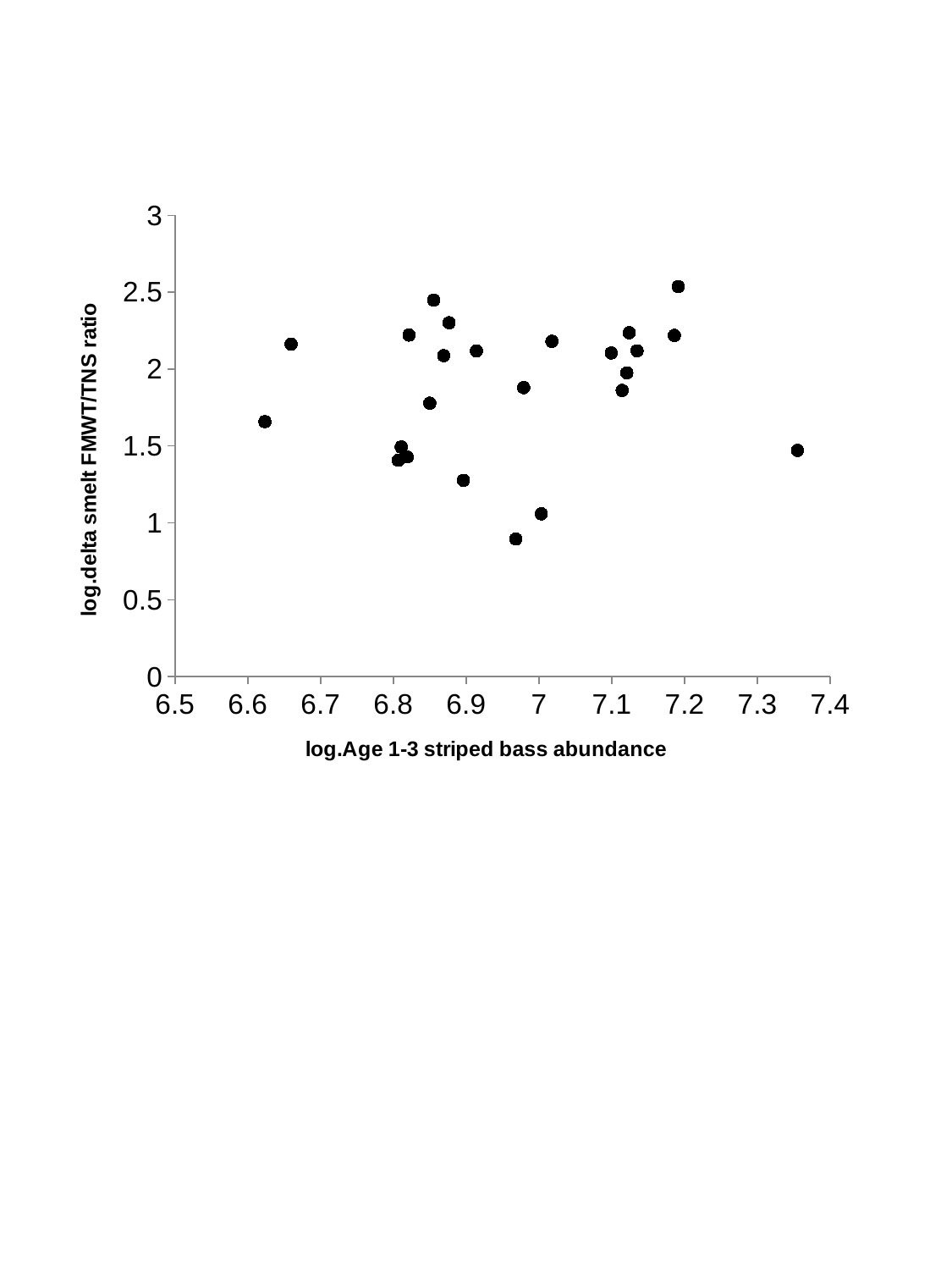
Is the y value of the highest point greater or less than 2? greater Is the x value of the rightmost point greater or less than 7.3? greater Is the x value of the leftmost point greater or less than 6.7? less What is the title of the x axis? log.Age 1-3 striped bass abundance Which has the larger y value, the leftmost point or the rightmost point? the leftmost point What kind of chart is shown on the slide? scatter plot What is the title of the y axis? log.delta smelt FMWT/TNS ratio